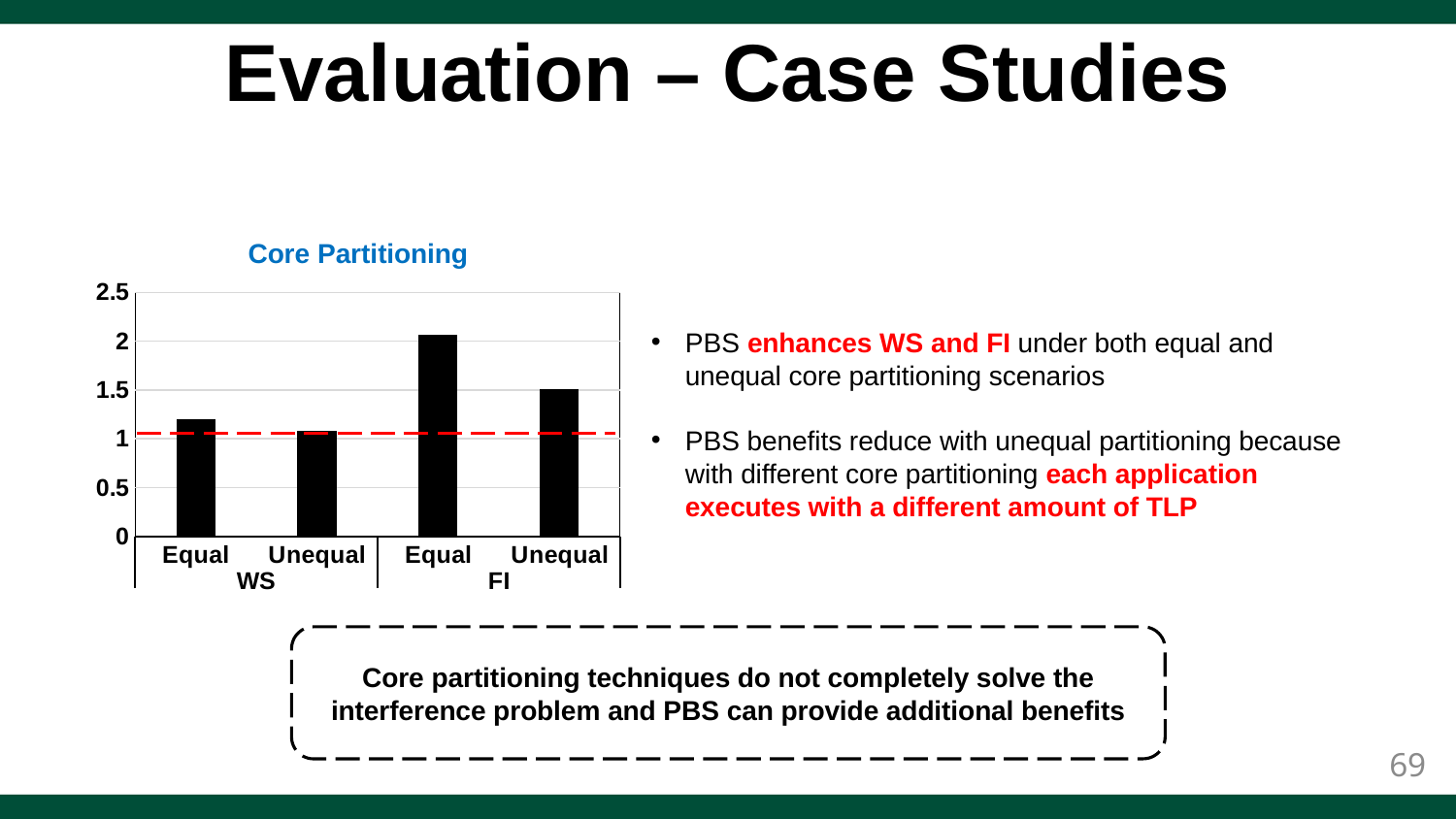
Which bar has the highest value in the chart? FI Equal What is the highest value shown on the y axis of the chart? 2.5 What kind of chart is shown on the slide? bar chart Is the value for FI Equal greater or less than 1.5? greater Which bar has the lowest value in the chart? WS Unequal What is the title of the chart? Core Partitioning Is the value for WS Unequal greater or less than 1.5? less Is the value for FI Unequal greater or less than 1? greater How many groups are labelled on the x axis of the chart? 2 How many bars are plotted in the chart? 4 Which is larger, the Equal bar or the Unequal bar in the FI group? Equal Which is larger, the WS Equal bar or the FI Unequal bar? FI Unequal